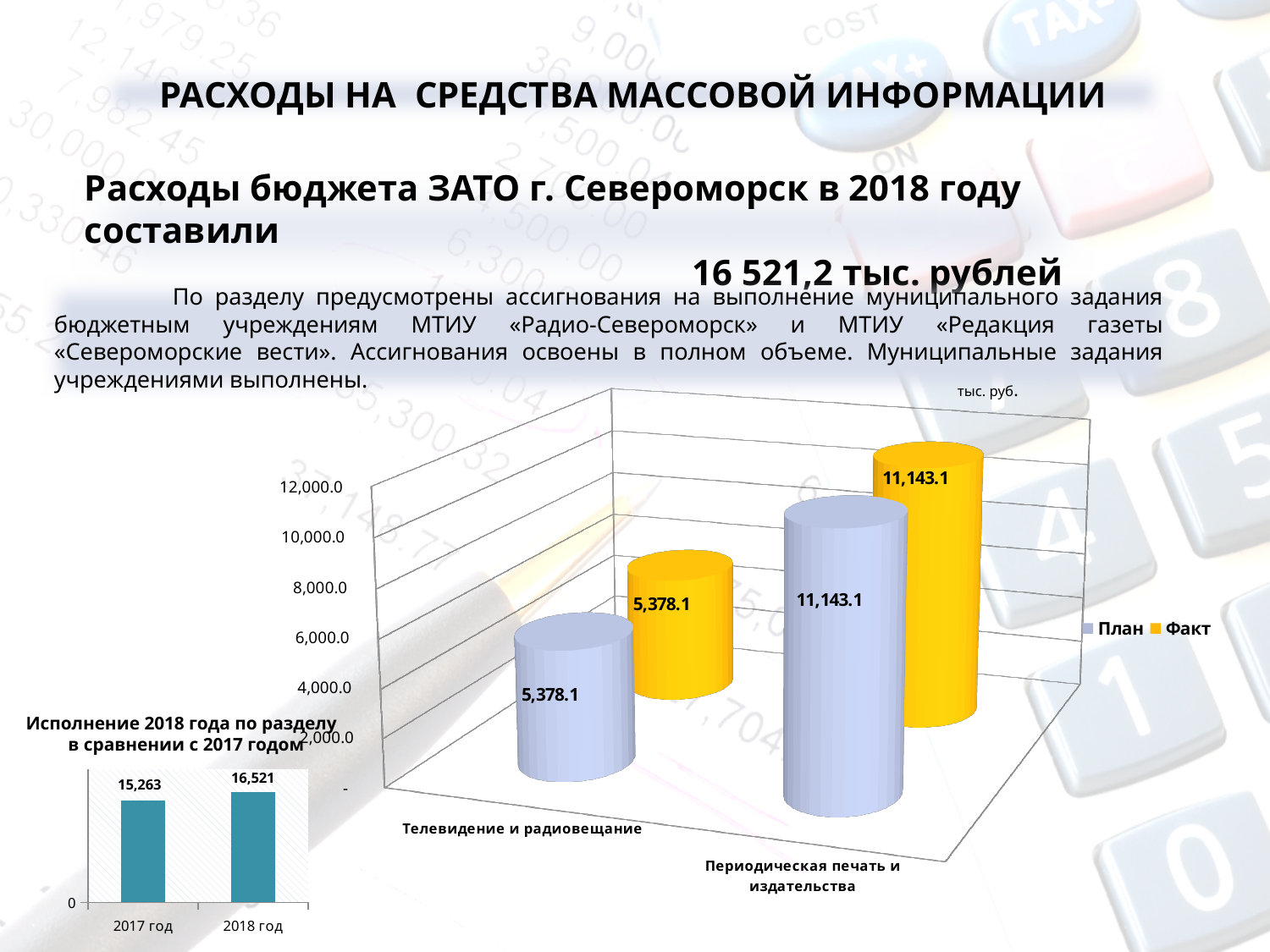
In the large chart on the right, how many series does the legend list? 2 In the chart titled 'Исполнение 2018 года по разделу в сравнении с 2017 годом', what is the difference between the 2018 год and 2017 год values? 1,258 In the large chart on the right, what is the План value for Телевидение и радиовещание? 5,378.1 In the large chart on the right, what is the Факт value for Периодическая печать и издательства? 11,143.1 In the chart titled 'Исполнение 2018 года по разделу в сравнении с 2017 годом', what is the value for 2017 год? 15,263 In the large chart on the right, how many categories are shown on the x axis? 2 In the large chart on the right, what is the difference between the Факт values for Периодическая печать и издательства and Телевидение и радиовещание? 5,765.0 In the large chart on the right, which colour represents Факт? Yellow In the chart titled 'Исполнение 2018 года по разделу в сравнении с 2017 годом', do the values rise or fall from 2017 год to 2018 год? Rise What kind of chart is the one titled 'Исполнение 2018 года по разделу в сравнении с 2017 годом'? Bar chart In the large chart on the right, which category has the higher values? Периодическая печать и издательства In the chart titled 'Исполнение 2018 года по разделу в сравнении с 2017 годом', what is the value for 2018 год? 16,521